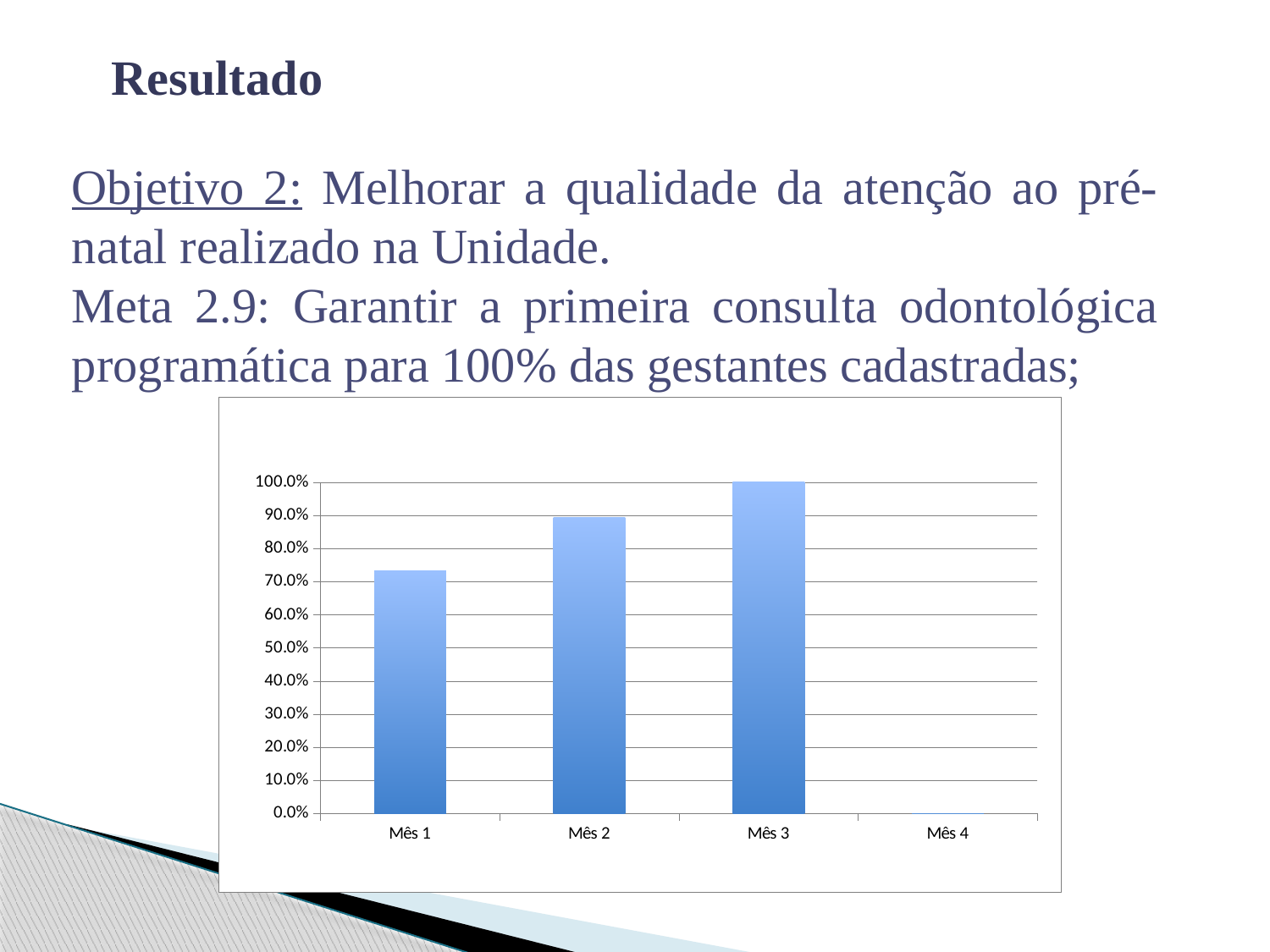
Is the value for Mês 1 greater or less than 80.0%? less What is the highest value shown on the y axis of the chart? 100.0% What is the value for Mês 3? 100.0% Do the values rise or fall from Mês 1 to Mês 3? rise Which is larger, the value for Mês 1 or the value for Mês 2? Mês 2 Which category on the x axis has no visible bar? Mês 4 Is the value for Mês 2 greater or less than 80.0%? greater Is the value for Mês 1 greater or less than 70.0%? greater Which month has the highest bar? Mês 3 How many categories are shown on the x axis of the chart? 4 What kind of chart is shown on the slide? bar chart